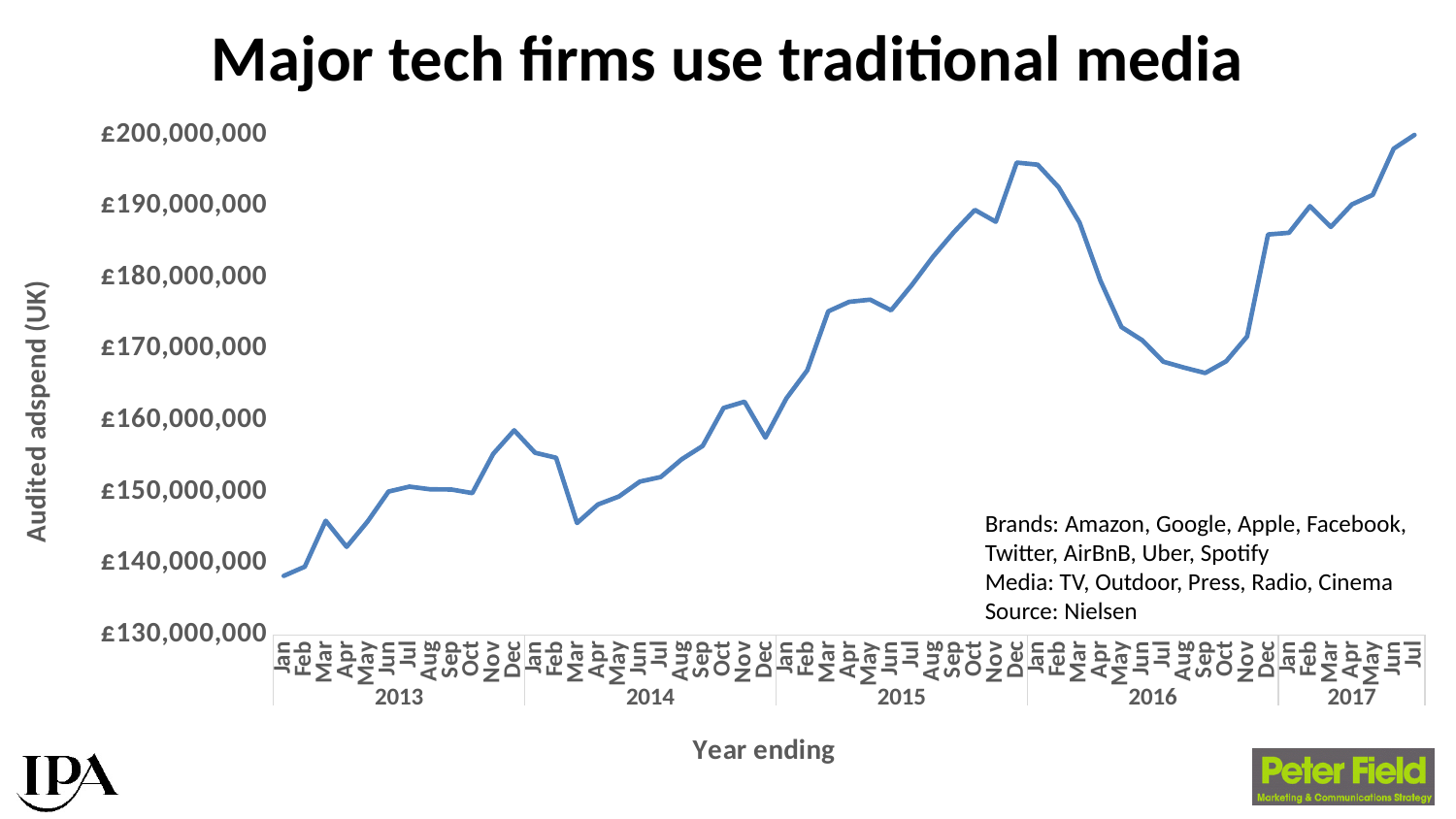
Overall, does audited adspend rise or fall from Jan 2013 to Jul 2017? rise What is the title of the chart? Major tech firms use traditional media Is the value for Jan 2016 greater or less than £190,000,000? greater What is the label on the vertical axis of the chart? Audited adspend (UK) What kind of chart is shown on the slide? line chart Which month has the highest audited adspend on the chart? Jul 2017 Which month has the lowest audited adspend on the chart? Jan 2013 Is the value for Jan 2013 greater or less than £140,000,000? less Is the value for Jul 2017 greater or less than £190,000,000? greater Which is larger, the value for Jan 2016 or the value for Sep 2016? Jan 2016 How many monthly data points are plotted on the chart? 55